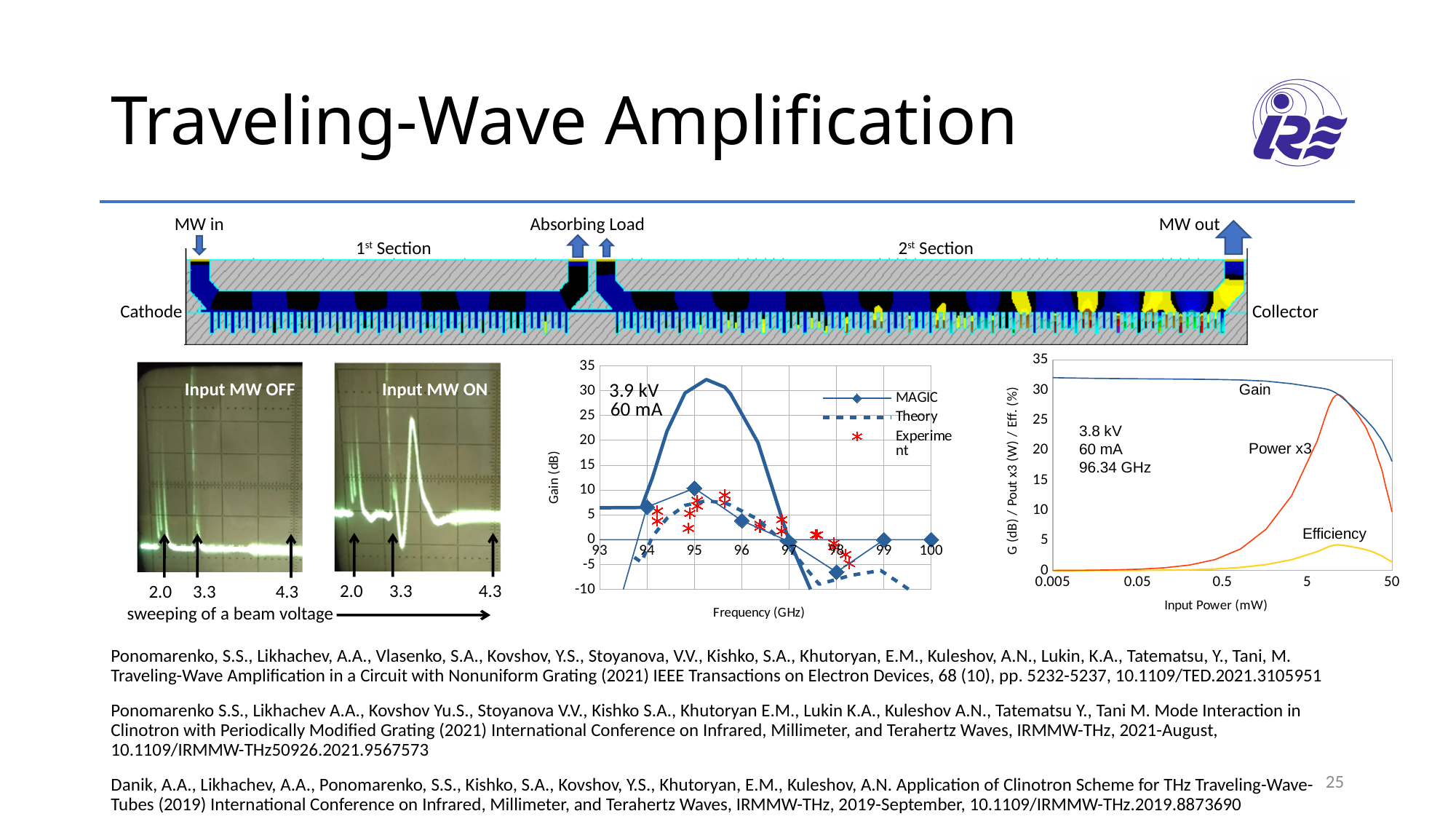
In the Gain vs Frequency chart, is the MAGIC gain at 98 GHz greater or less than 0 dB? less In the Gain vs Frequency chart, at which frequency does the MAGIC series reach its highest marker? 95 GHz In the Input Power chart on the right, is the Gain at 0.005 mW input power greater or less than 30? greater In the Input Power chart on the right, does the Gain curve rise or fall as input power increases? fall In the Input Power chart on the right, how many tick labels are shown on the x axis? 5 What kind of chart is the Gain vs Frequency chart? line chart In the Input Power chart on the right, is the peak of the Efficiency curve greater or less than 5? less In the Gain vs Frequency chart, how many series does the legend list? 3 In the Gain vs Frequency chart, what is the label of the x axis? Frequency (GHz) In the Gain vs Frequency chart, what are the three legend entries? MAGIC, Theory, Experiment